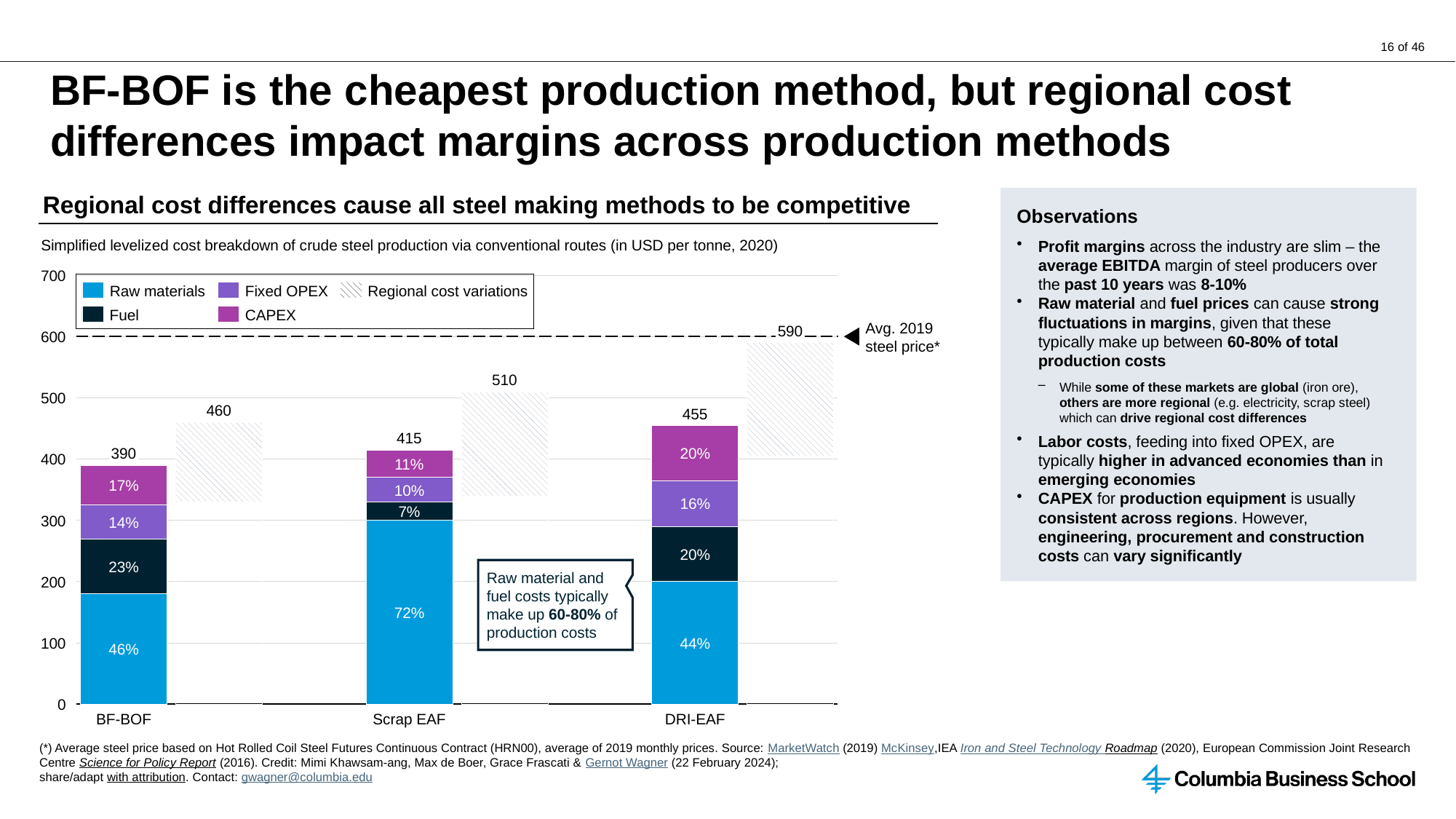
Which has a larger CAPEX share, BF-BOF or Scrap EAF? BF-BOF What is the upper value of the regional cost variation shown for DRI-EAF? 590 Which production method has the highest total levelized cost? DRI-EAF What share of production costs do raw materials make up for Scrap EAF? 72% What is the difference between the total levelized cost of DRI-EAF and BF-BOF? 65 What is the total levelized cost shown for BF-BOF? 390 How many production methods are shown on the x axis? 3 How many entries does the legend list? 5 Which production method has the lowest total levelized cost? BF-BOF What share of production costs does fuel make up for BF-BOF? 23% What is the total levelized cost shown for DRI-EAF? 455 What kind of chart is shown on the slide? Stacked bar chart